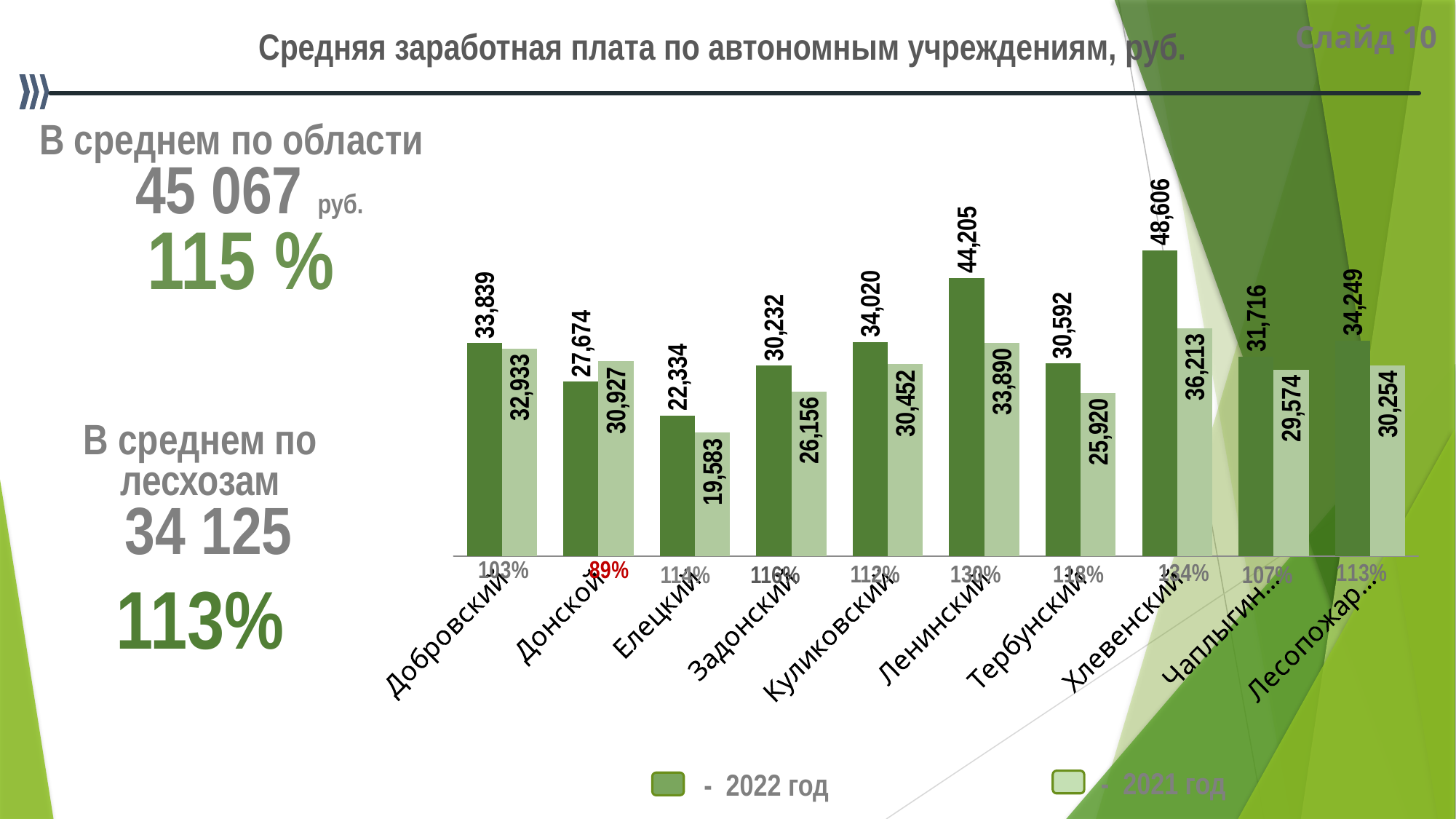
What is the 2021 год value for Донской? 30,927 What is the 2021 год value for Елецкий? 19,583 How many series does the legend list? 2 How many categories are shown on the x axis of the chart? 10 What kind of chart is shown on the slide? bar chart What is the 2022 год value for Хлевенский? 48,606 Which category has the highest 2022 год value? Хлевенский What is the title of the chart? Средняя заработная плата по автономным учреждениям, руб. What is the difference between the 2022 год and 2021 год values for Ленинский? 10,315 For Донской, which is larger: the 2022 год value or the 2021 год value? 2021 год What is the 2022 год value for Ленинский? 44,205 Which category has the lowest 2021 год value? Елецкий